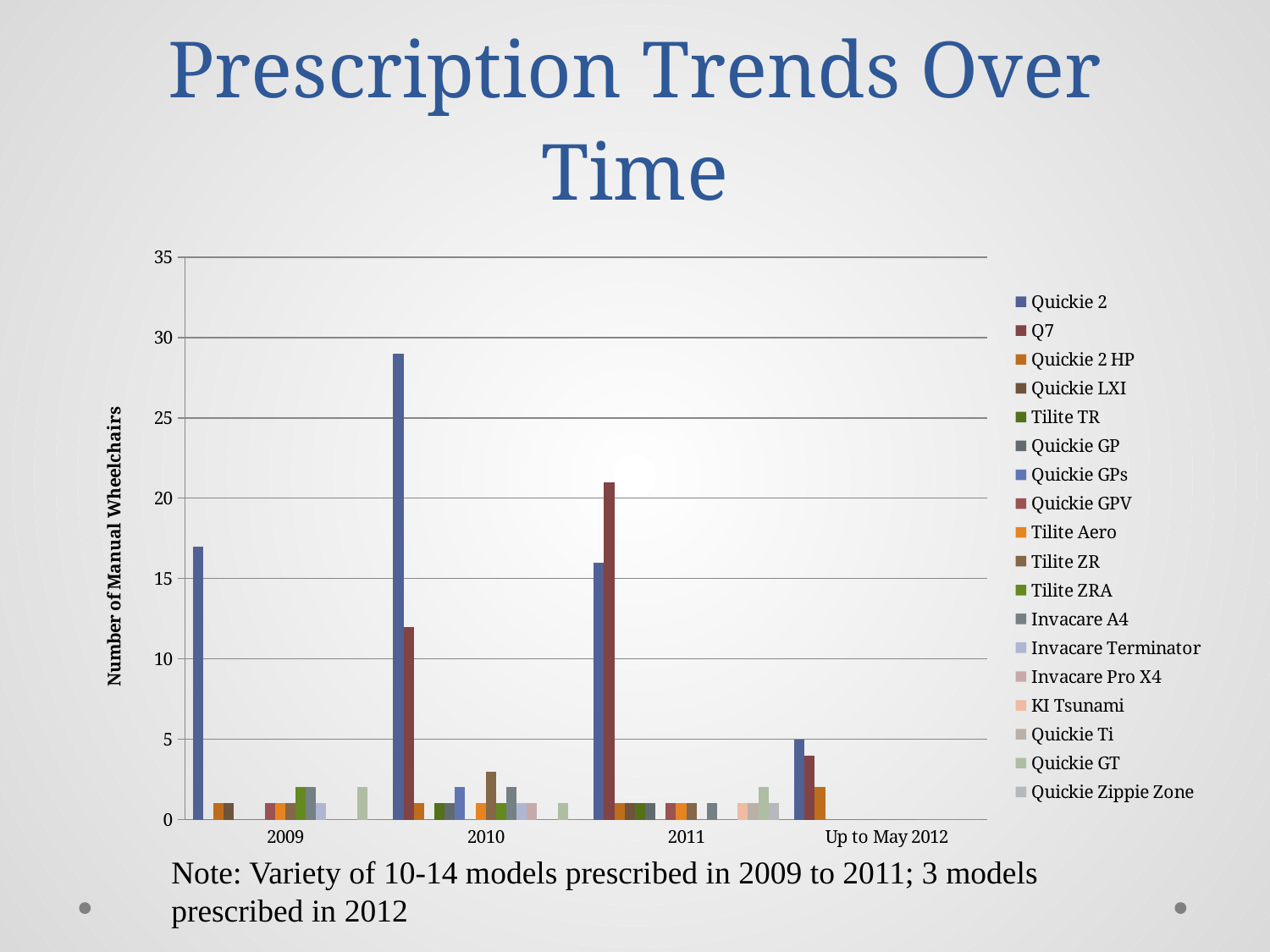
In 2011, which is larger, Quickie 2 or Q7? Q7 Is the value for Quickie 2 in 2009 greater or less than 15? greater Is the value for Quickie 2 in Up to May 2012 greater or less than 10? less What is the title of the y axis? Number of Manual Wheelchairs Does the Q7 value rise or fall from 2009 to 2011? rise How many categories are shown on the x axis? 4 How many series does the legend list? 18 In 2010, which is larger, Quickie 2 or Q7? Quickie 2 Is the value for Q7 in 2010 greater or less than 10? greater What kind of chart is shown on the slide? bar chart In which category is the Quickie 2 bar highest? 2010